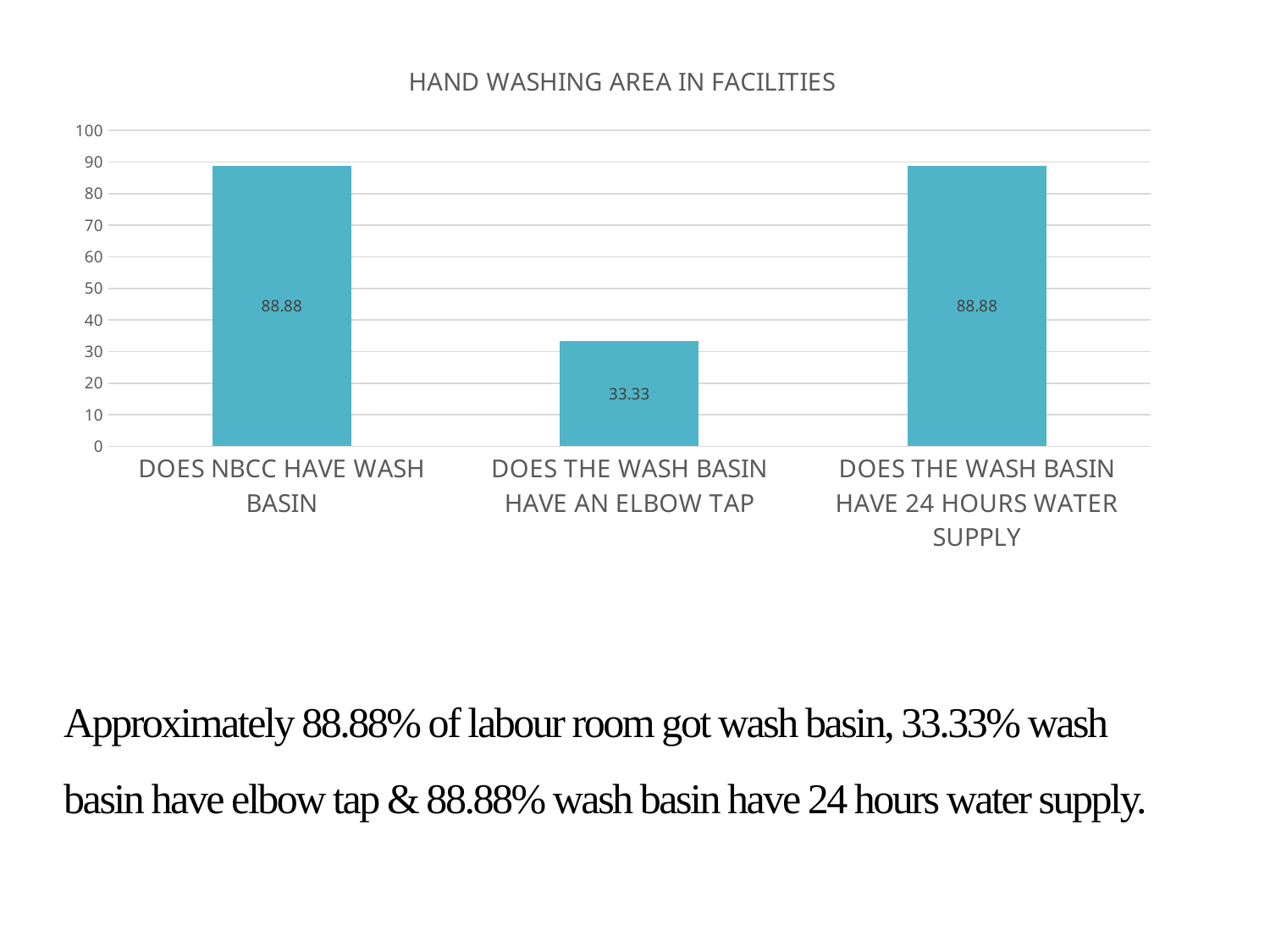
What is the value for 'Does the wash basin have an elbow tap'? 33.33 Is the value for 'Does NBCC have wash basin' greater or less than 80? greater What is the value for 'Does the wash basin have 24 hours water supply'? 88.88 What is the value for 'Does NBCC have wash basin'? 88.88 Is the value for 'Does the wash basin have an elbow tap' greater or less than 50? less What is the difference between the value for 'Does NBCC have wash basin' and the value for 'Does the wash basin have an elbow tap'? 55.55 What is the maximum value shown on the vertical axis? 100 What is the title of the chart? Hand washing area in facilities What kind of chart is shown on the slide? Bar chart Which is larger: the value for 'Does the wash basin have 24 hours water supply' or the value for 'Does the wash basin have an elbow tap'? Does the wash basin have 24 hours water supply Which category has the lowest value? Does the wash basin have an elbow tap How many categories are shown on the chart? 3